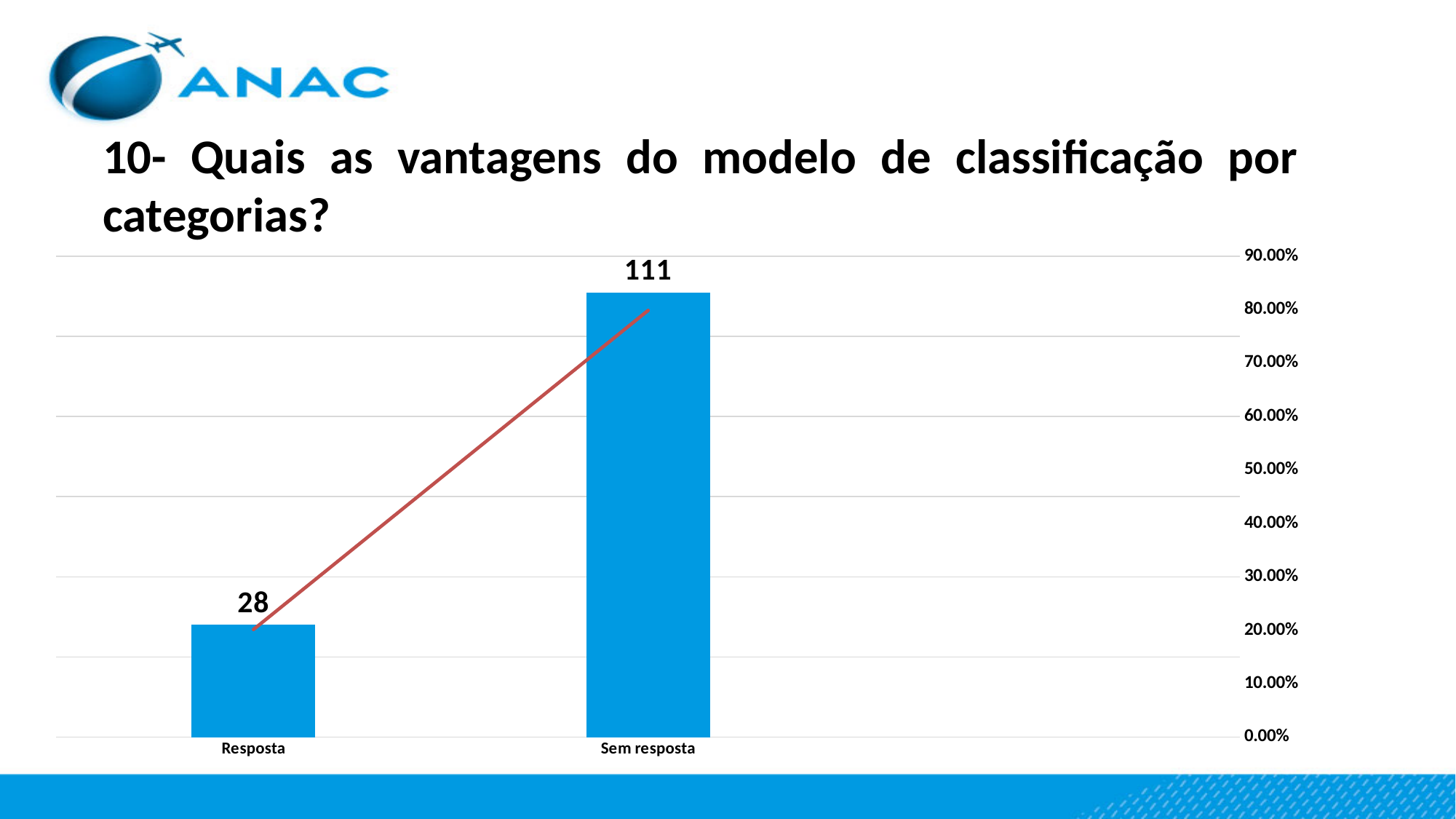
What is the value for Sem resposta? 111 Which category has the highest value? Sem resposta What is the value for Resposta? 28 What is the highest tick label shown on the right-hand axis? 90.00% How many categories are shown on the x axis? 2 Which category has the lowest value? Resposta What is the difference between the values for Sem resposta and Resposta? 83 What kind of chart is shown on the slide? Combination bar and line chart Do the bar values rise or fall from Resposta to Sem resposta? Rise What colour are the bars in the chart? Blue What is the total of the two bar values? 139 Which is larger, the value for Resposta or the value for Sem resposta? Sem resposta